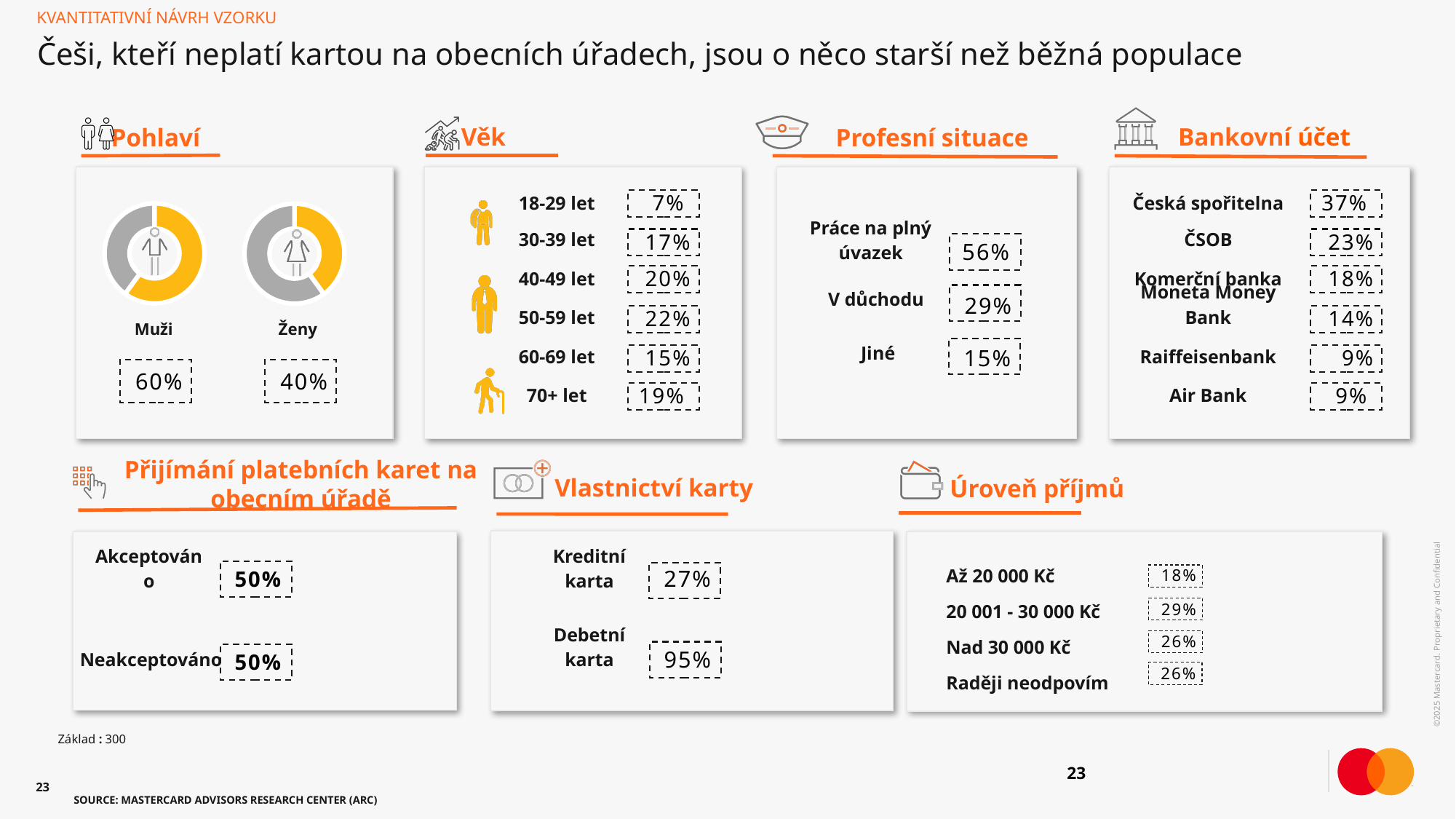
In the Pohlaví section, what is the difference in percentage points between Muži and Ženy? 20 percentage points What colour is used for the highlighted share in the Pohlaví donut charts? Orange In the Pohlaví section, is the value for Ženy greater or less than 50%? less What is the title of the section containing the donut charts? Pohlaví In the Pohlaví section, which group has the larger share, Muži or Ženy? Muži What kind of charts are shown in the Pohlaví section? Donut (pie) charts How many donut charts are shown in the Pohlaví section? 2 In the Pohlaví section, what share of the Muži donut is filled in orange? 60% In the Pohlaví section, what percentage is shown for Muži? 60% In the Pohlaví section, what percentage is shown for Ženy? 40%